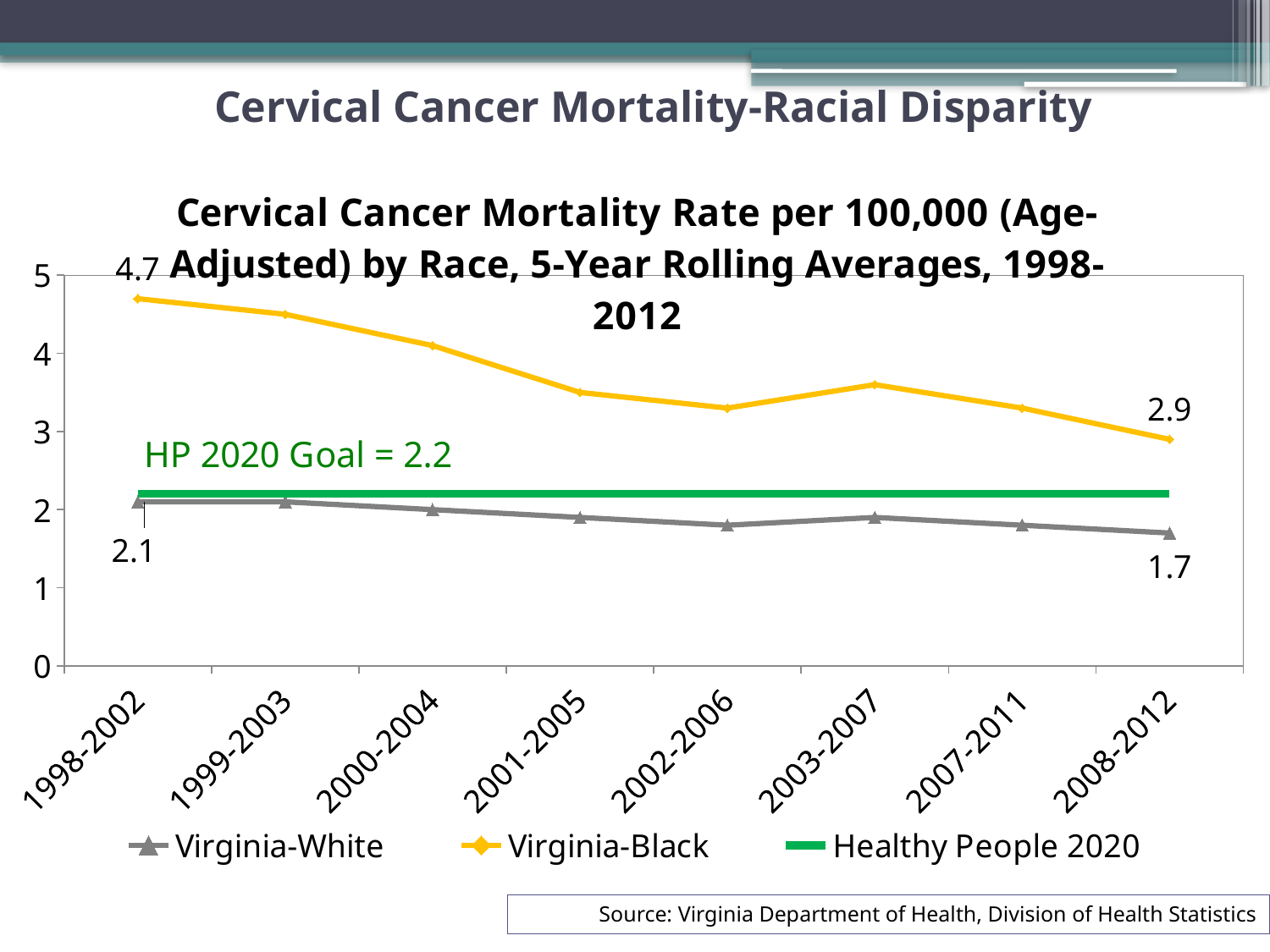
By how much did the Virginia-Black rate fall from 1998-2002 to 2008-2012? 1.8 What is the Virginia-Black cervical cancer mortality rate for 2008-2012? 2.9 Which series has the higher rate in 1998-2002, Virginia-White or Virginia-Black? Virginia-Black What kind of chart is shown on the slide? line chart How many series does the legend list? 3 What is the difference between the Virginia-Black and Virginia-White rates in 2008-2012? 1.2 What is the Virginia-White cervical cancer mortality rate for 2008-2012? 1.7 Is the Virginia-Black value for 2003-2007 greater or less than 3? greater What is the Virginia-White cervical cancer mortality rate for 1998-2002? 2.1 What is the HP 2020 Goal value shown on the chart? 2.2 How many time periods are shown on the x axis? 8 What is the Virginia-Black cervical cancer mortality rate for 1998-2002? 4.7